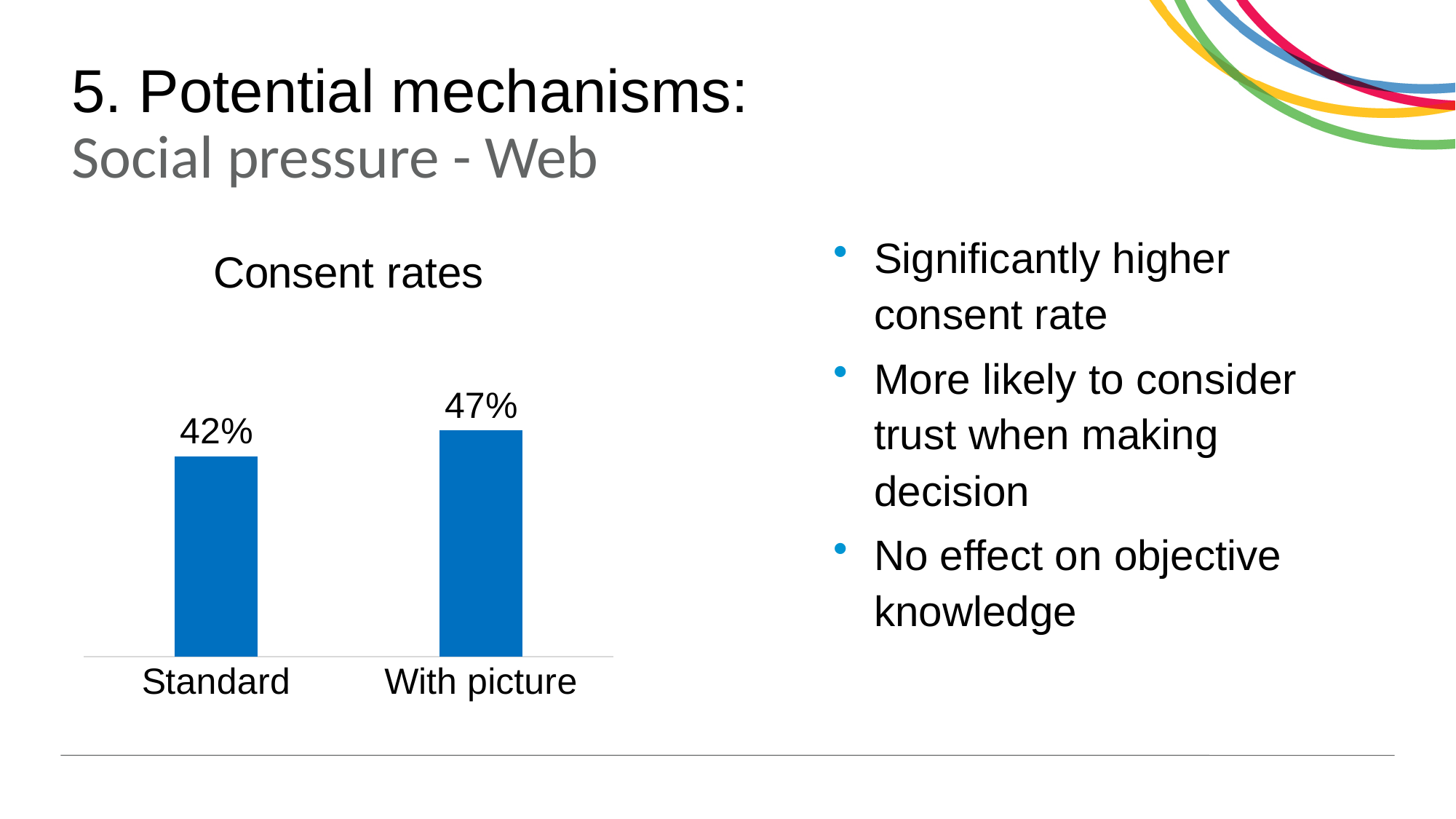
Do the consent rates rise or fall from Standard to With picture? Rise What is the consent rate for the With picture condition? 47% What colour are the bars in the chart? Blue Which category has the lowest consent rate? Standard What is the consent rate for the Standard condition? 42% What is the difference in consent rate between With picture and Standard? 5% Which has a higher consent rate, Standard or With picture? With picture What kind of chart is shown on the slide? Bar chart What is the title of the chart? Consent rates Which category has the highest consent rate? With picture How many categories are shown in the chart? 2